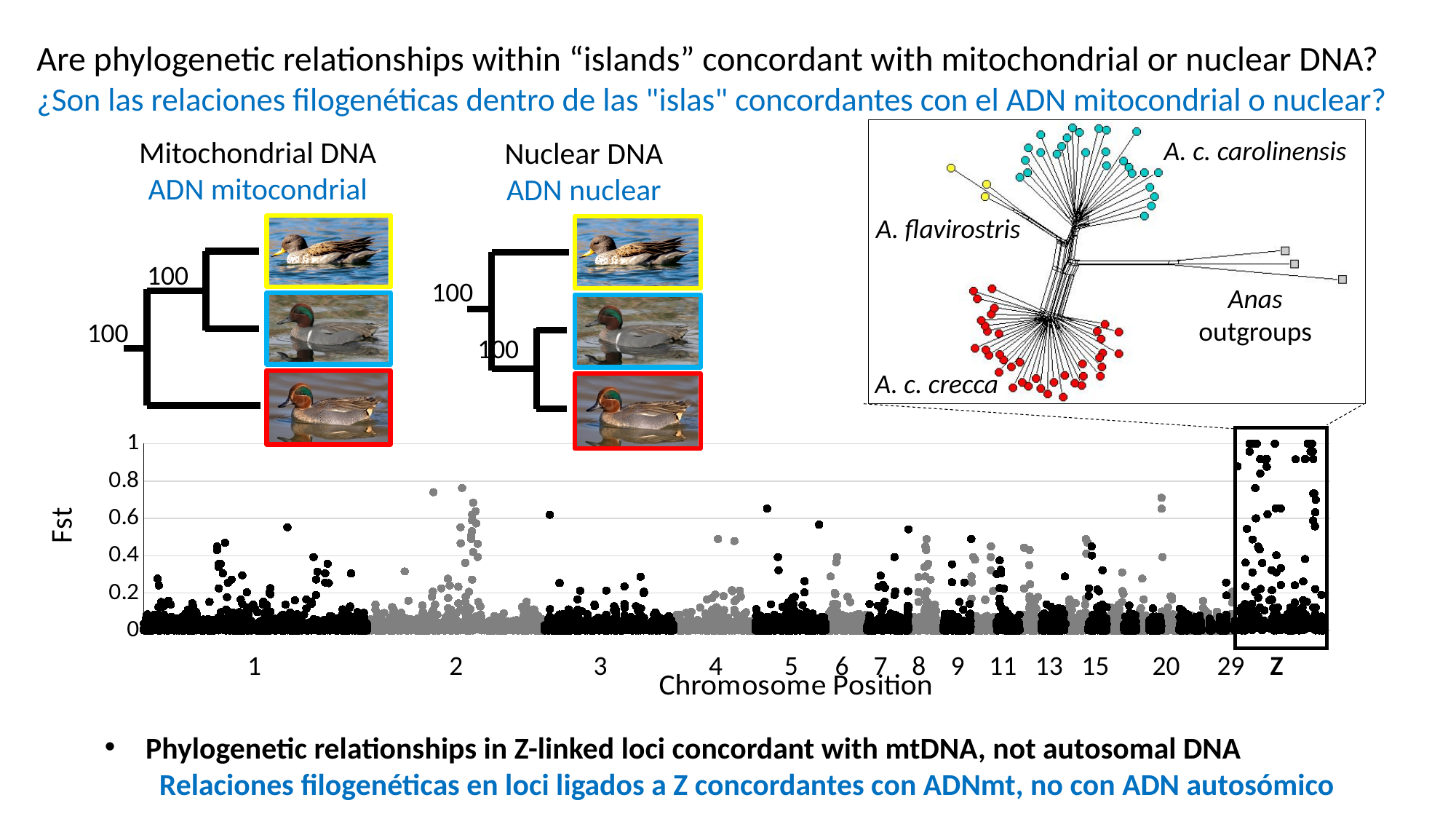
Is the highest Fst value on chromosome 1 greater or less than 0.8? less What is the label on the x axis of the Fst chart? Chromosome Position Which chromosome has higher maximum Fst values in the chart, chromosome Z or chromosome 1? Z What is the label on the y axis of the Fst chart? Fst What kind of chart is the Fst plot on the slide? scatter plot Is the highest Fst value on chromosome 5 greater or less than 0.8? less Is the highest Fst value on chromosome Z greater or less than 0.8? greater Which chromosome in the Fst chart has the highest Fst values? Z What is the highest tick value on the y axis of the Fst chart? 1 How many chromosome labels are shown along the x axis of the Fst chart? 15 Which chromosome has higher maximum Fst values in the chart, chromosome 2 or chromosome 9? chromosome 2